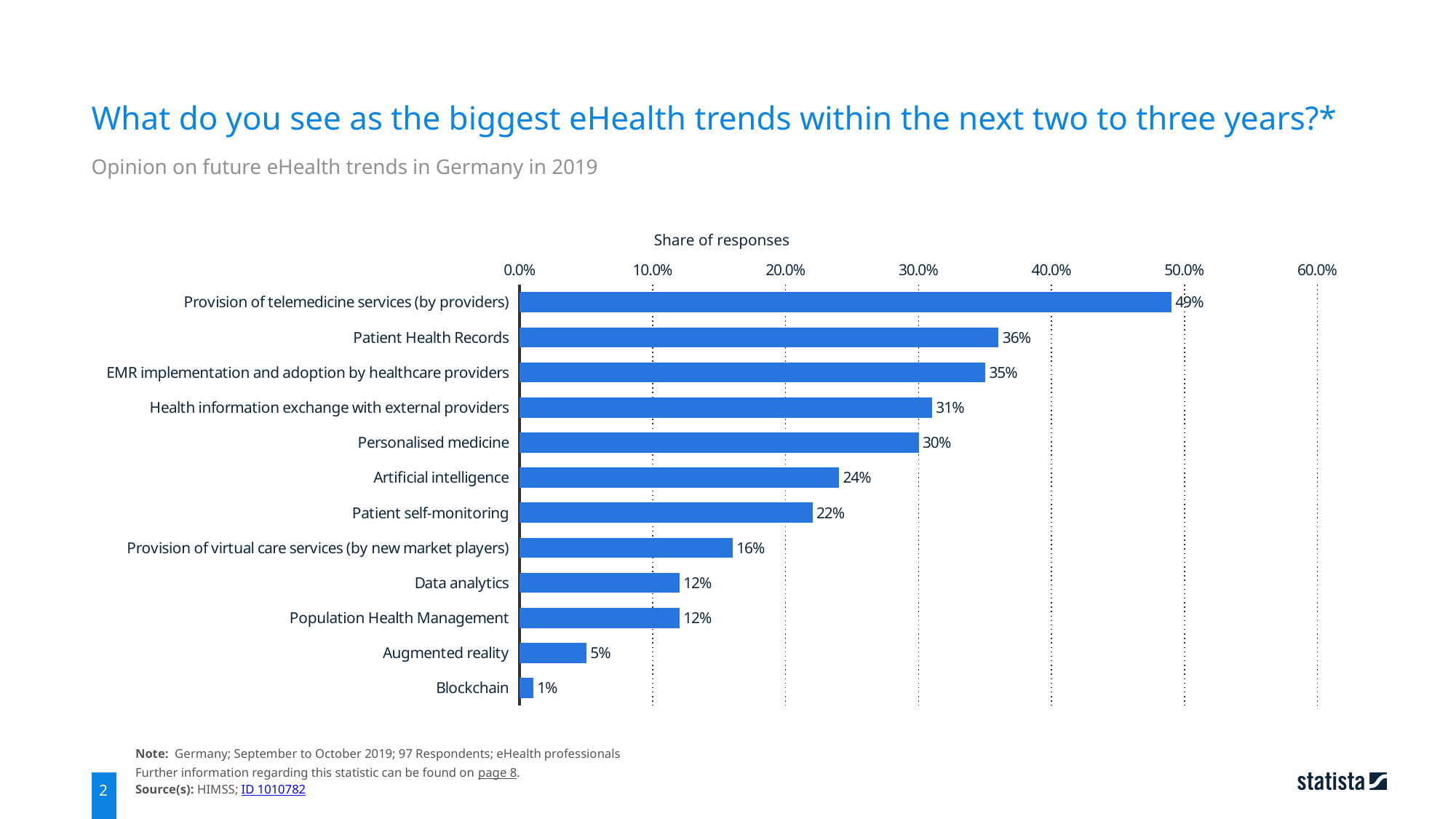
What is the difference in share of responses between Patient Health Records and Personalised medicine? 6% How many categories are shown in the chart? 12 Which category has the lowest share of responses? Blockchain What is the share of responses for Augmented reality? 5% What is the share of responses for Artificial intelligence? 24% What is the label of the value axis of the chart? Share of responses What kind of chart is shown on the slide? Bar chart What is the share of responses for Provision of telemedicine services (by providers)? 49% Which has a larger share of responses, Patient self-monitoring or Provision of virtual care services (by new market players)? Patient self-monitoring Is the value for Health information exchange with external providers greater or less than 30.0%? greater What is the difference in share of responses between Provision of telemedicine services (by providers) and Blockchain? 48% Which category has the highest share of responses? Provision of telemedicine services (by providers)